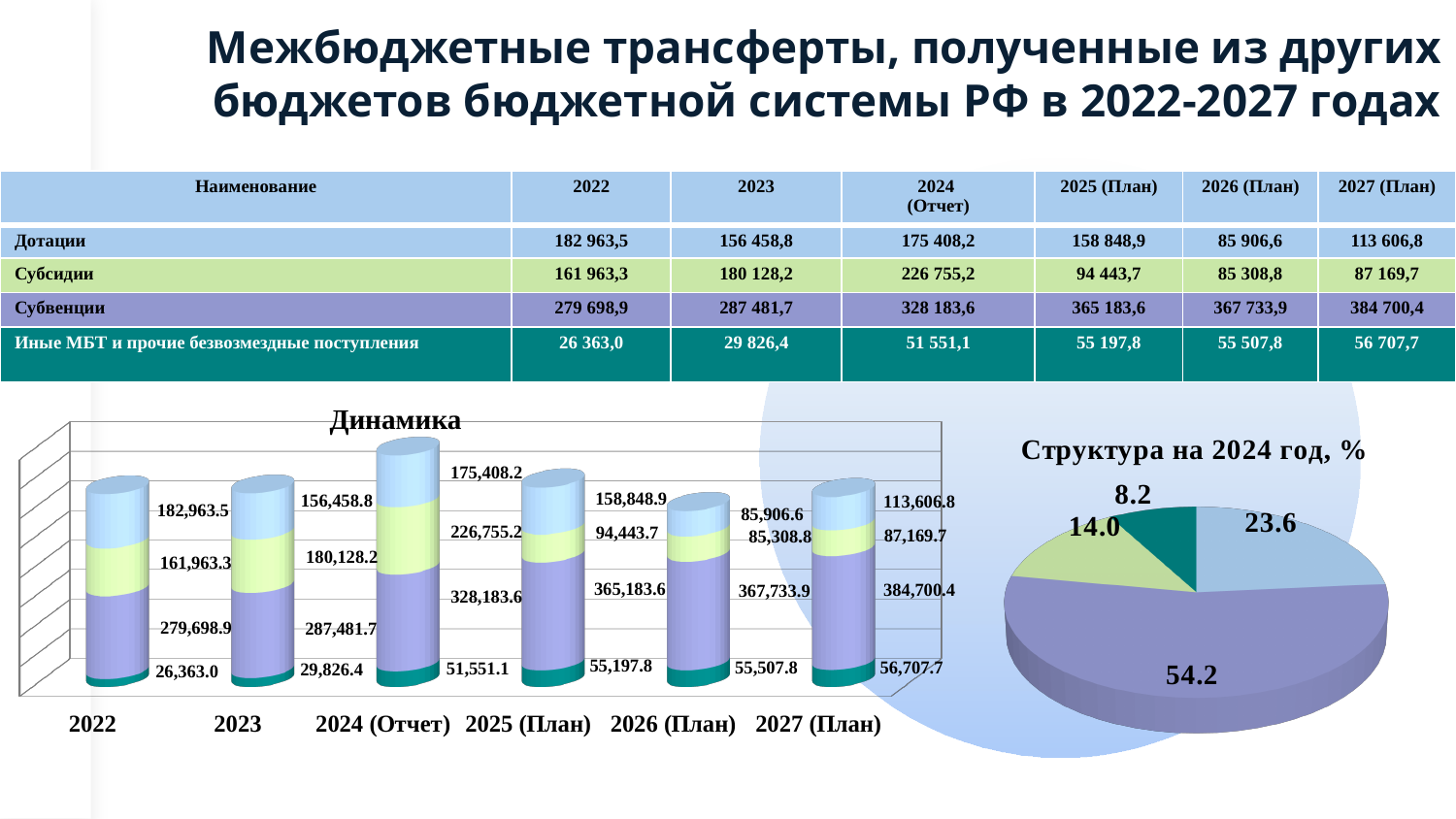
In the "Динамика" chart, what is the total of the stacked bar for 2022? 650,988.7 What type of chart is the "Динамика" chart? stacked bar chart In the "Динамика" chart, what is the value of the bottom (purple) segment for 2024 (Отчет)? 328,183.6 How many year categories are shown on the x axis of the "Динамика" chart? 6 In the "Динамика" chart, which year has the shortest stacked bar? 2026 (План) In the "Структура на 2024 год, %" chart, what is the share of the largest slice? 54.2 In the "Динамика" chart, which year has the tallest stacked bar? 2024 (Отчет) In the "Динамика" chart, do the values of the bottom (purple) segment rise or fall from 2022 to 2027 (План)? rise In the "Динамика" chart, what is the value of the top (light blue) segment for 2022? 182,963.5 In the "Динамика" chart, what is the difference between the bottom (purple) segment values for 2027 (План) and 2026 (План)? 16,966.5 What type of chart is the "Структура на 2024 год, %" chart? pie chart In the "Структура на 2024 год, %" chart, how many slices does the pie have? 4